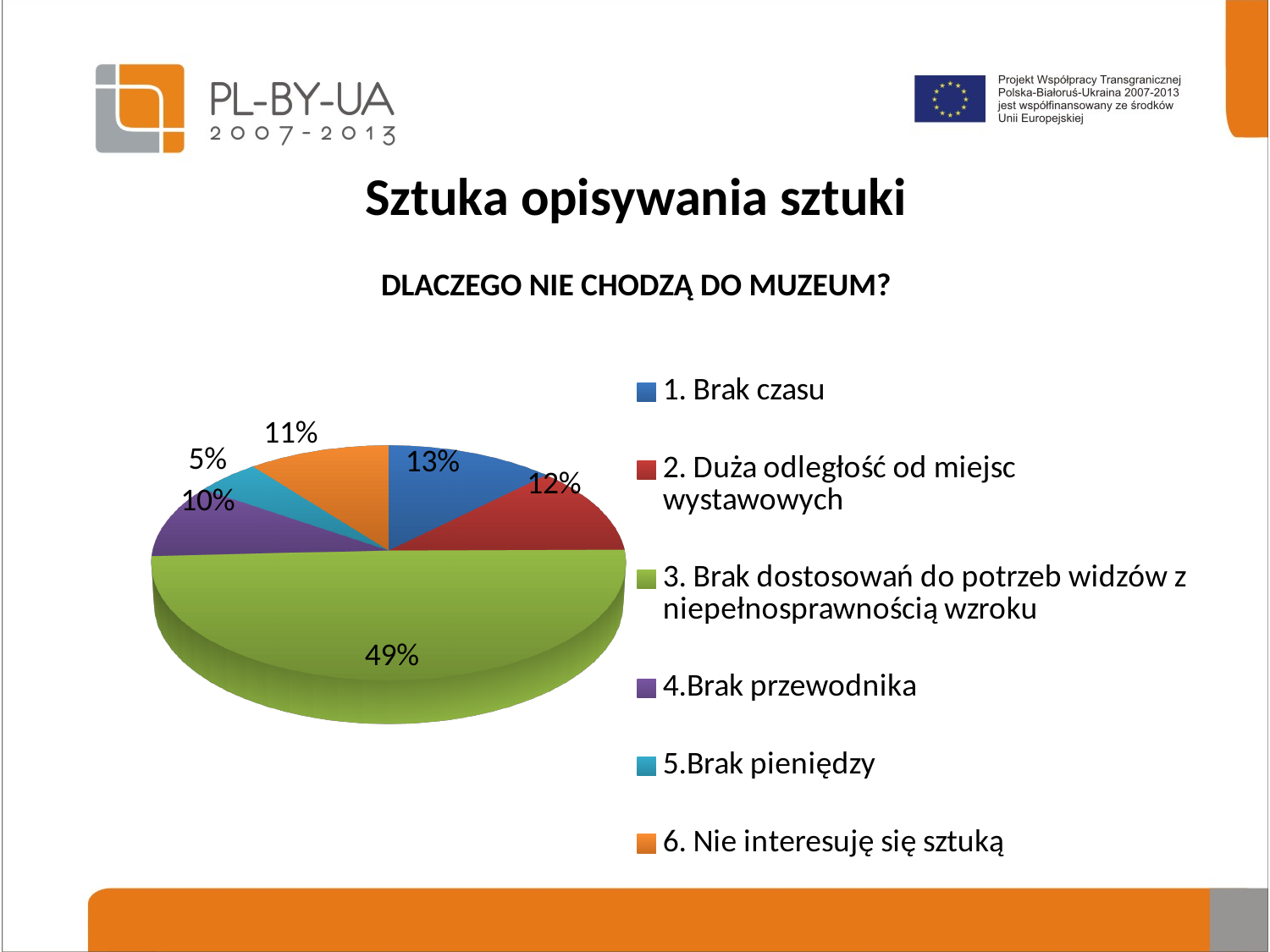
What share of the pie is labelled for "4.Brak przewodnika"? 10% What kind of chart is shown on the slide? pie chart What share of the pie is labelled for "5.Brak pieniędzy"? 5% What share of the pie is labelled for "1. Brak czasu"? 13% What is the difference in percentage points between "1. Brak czasu" and "2. Duża odległość od miejsc wystawowych"? 1% Which is larger: the slice for "4.Brak przewodnika" or the slice for "6. Nie interesuję się sztuką"? 6. Nie interesuję się sztuką What share of the pie is labelled for "3. Brak dostosowań do potrzeb widzów z niepełnosprawnością wzroku"? 49% How many categories does the legend list? 6 What share of the pie is labelled for "6. Nie interesuję się sztuką"? 11% Which category has the largest slice of the pie? 3. Brak dostosowań do potrzeb widzów z niepełnosprawnością wzroku What colour is the slice for "2. Duża odległość od miejsc wystawowych"? red Which category has the smallest slice of the pie? 5.Brak pieniędzy